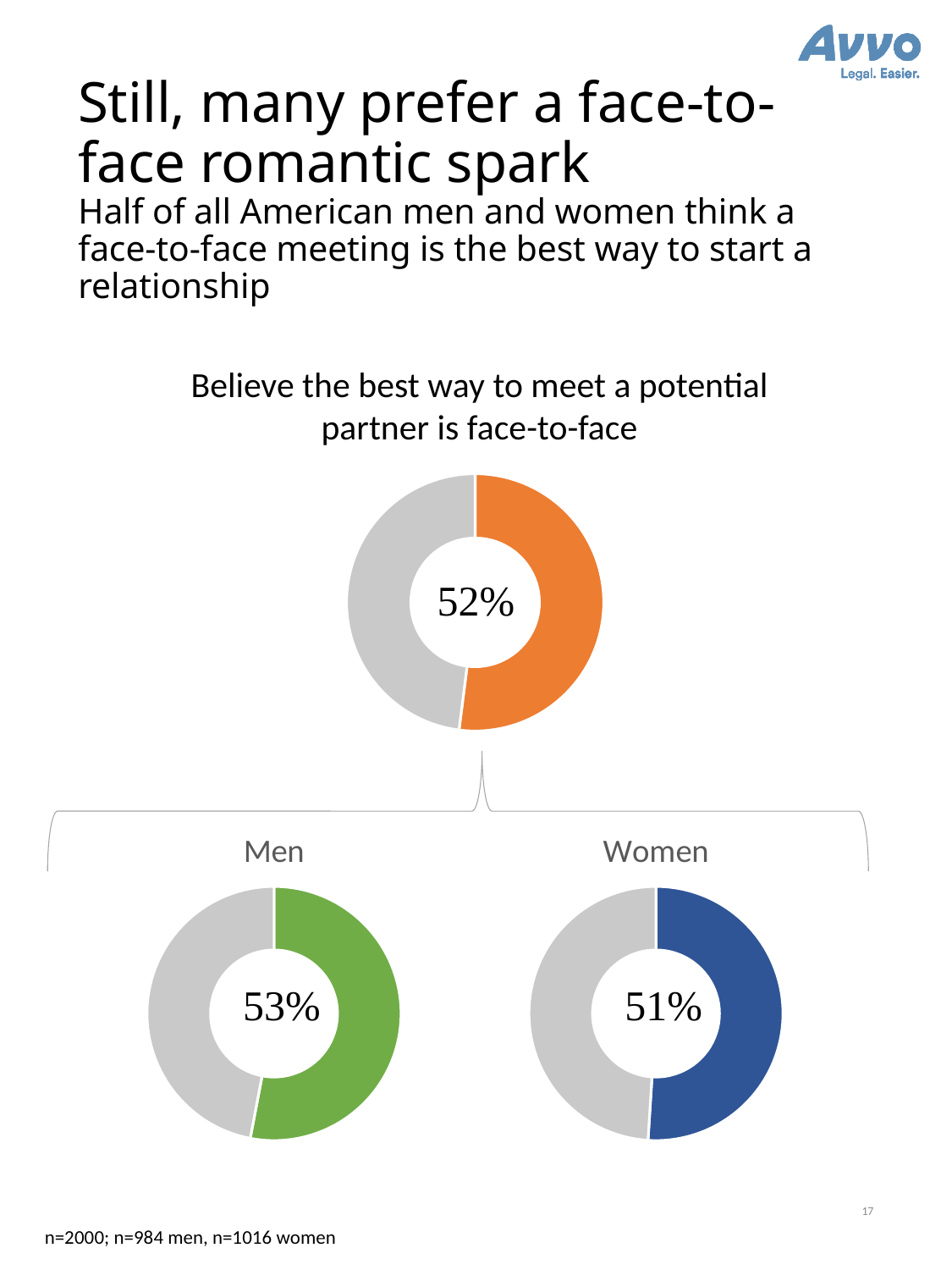
On the 'Men' chart at the bottom left, what percentage is shown? 53% What is the difference between the percentage shown on the 'Men' chart and the percentage shown on the 'Women' chart? 2% Of the three charts on the slide, which one shows the lowest percentage? Women On the top chart, is the highlighted share greater or less than 50%? greater What type of chart is used for the 'Men' chart? Doughnut chart Comparing the 'Men' and 'Women' charts, which group has the higher percentage believing the best way to meet a potential partner is face-to-face? Men On the top chart, what share of the doughnut is not highlighted (shown in grey)? 48% What colour is the highlighted segment on the 'Men' chart? Green What colour is the highlighted segment on the 'Women' chart? Blue How many doughnut charts are shown on the slide? 3 On the 'Women' chart at the bottom right, what percentage is shown? 51% On the top chart titled 'Believe the best way to meet a potential partner is face-to-face', what percentage is shown in the centre of the doughnut? 52%